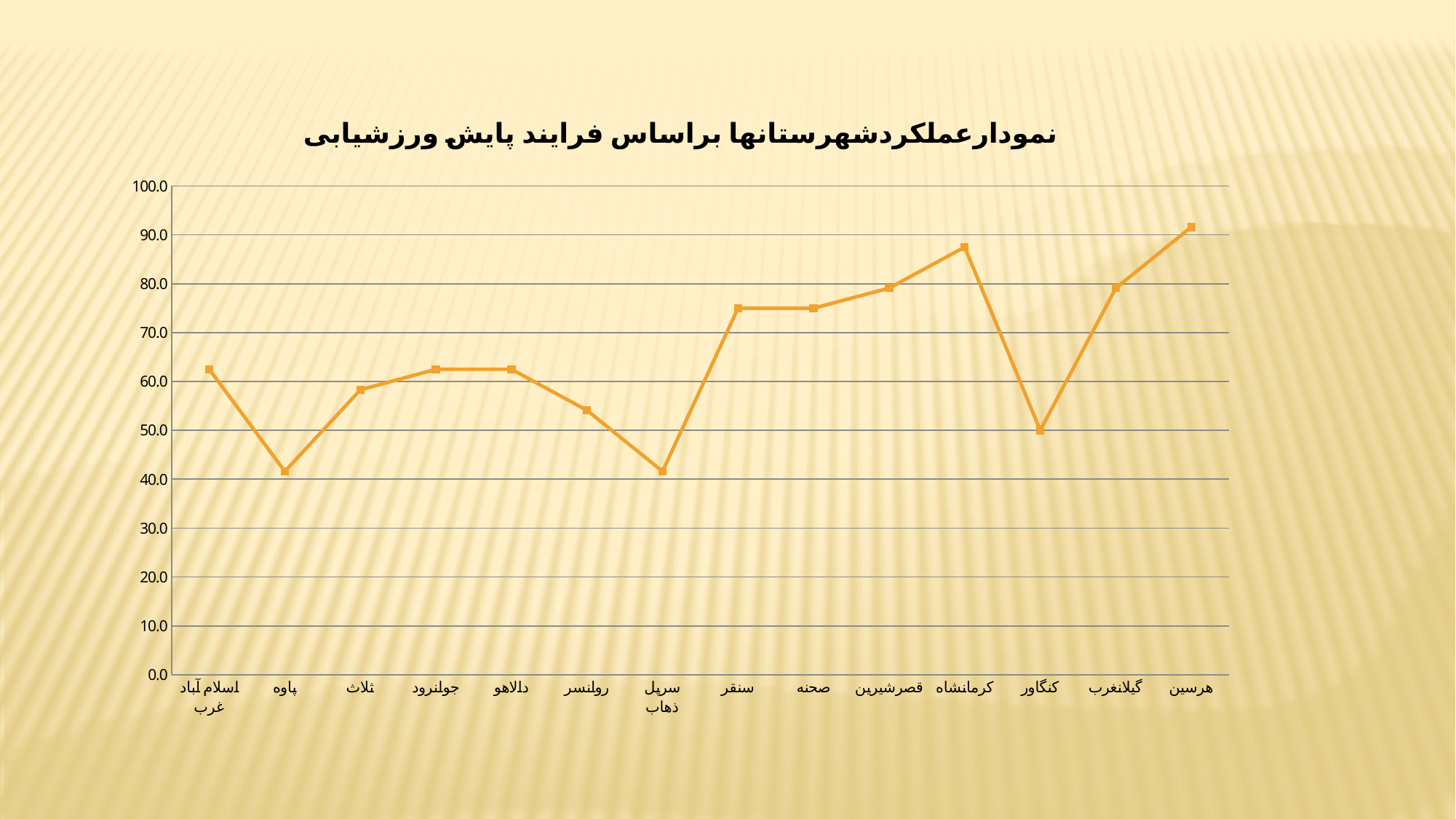
Is the value for سنقر greater or less than 70? greater How many categories (cities) are plotted along the x axis? 14 Is the value for کرمانشاه greater or less than 80? greater Which has the larger value, قصرشیرین or روانسر? قصرشیرین Which category has the highest value? هرسین Is the value for سرپل ذهاب greater or less than 50? less Which has the larger value, کرمانشاه or کنگاور? کرمانشاه What is the title of the chart? نمودارعملکردشهرستانها براساس فرایند پایش ورزشیابی What kind of chart is shown on the slide? line chart Moving along the x axis from سرپل ذهاب to کرمانشاه, do the values rise or fall? rise